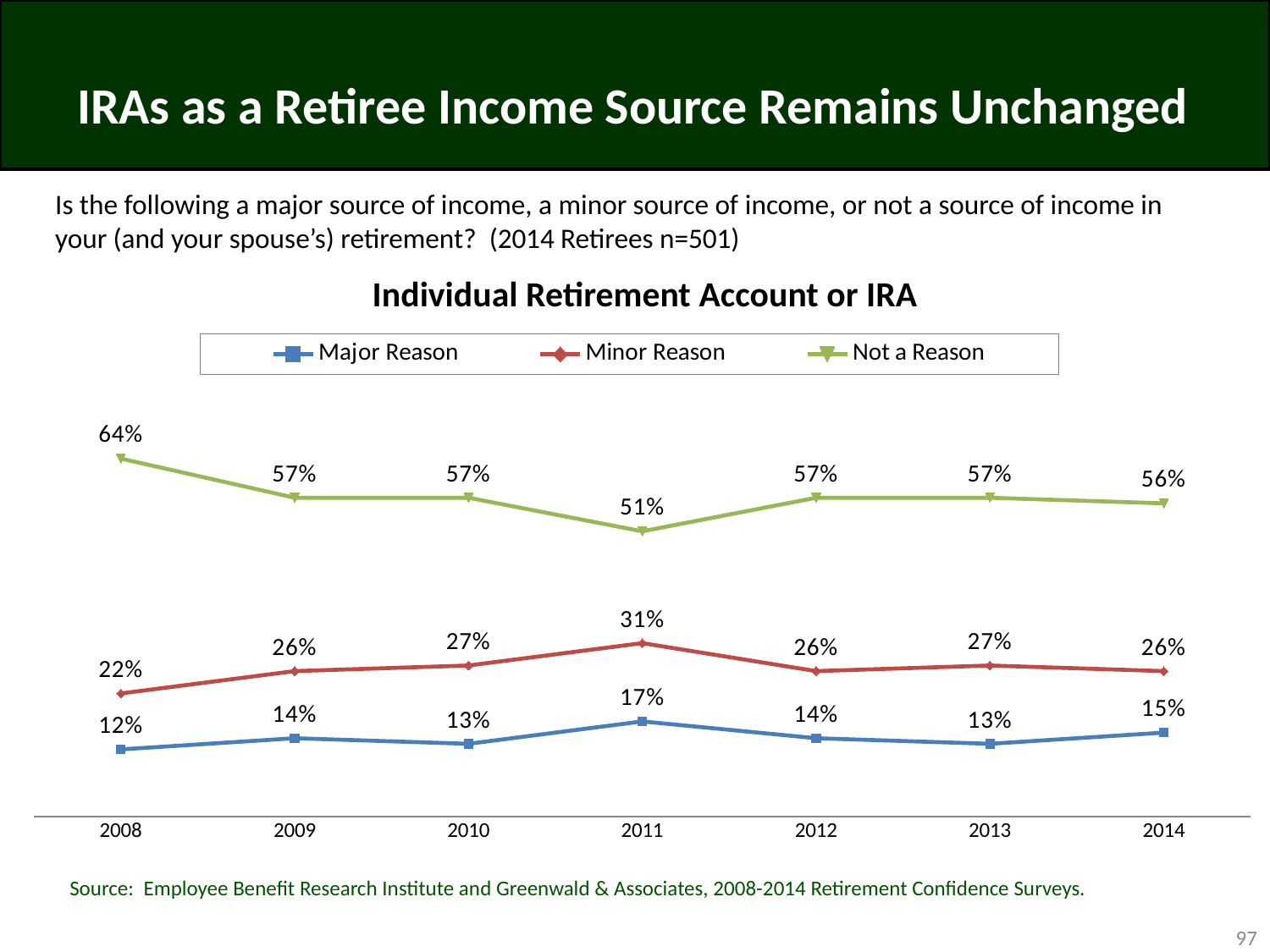
What is the value for Not a Reason in 2008? 64% How many series does the legend list? 3 What is the difference between the Minor Reason and Major Reason values in 2011? 14 percentage points What is the value for Minor Reason in 2011? 31% What kind of chart is shown? Line chart In which year is the Not a Reason series lowest? 2011 How many years are shown on the x axis? 7 Which is larger in 2012: Minor Reason or Major Reason? Minor Reason In which year is the Major Reason series highest? 2011 What is the difference between the Not a Reason value in 2008 and in 2014? 8 percentage points What is the value for Major Reason in 2014? 15% What is the title of the chart? Individual Retirement Account or IRA